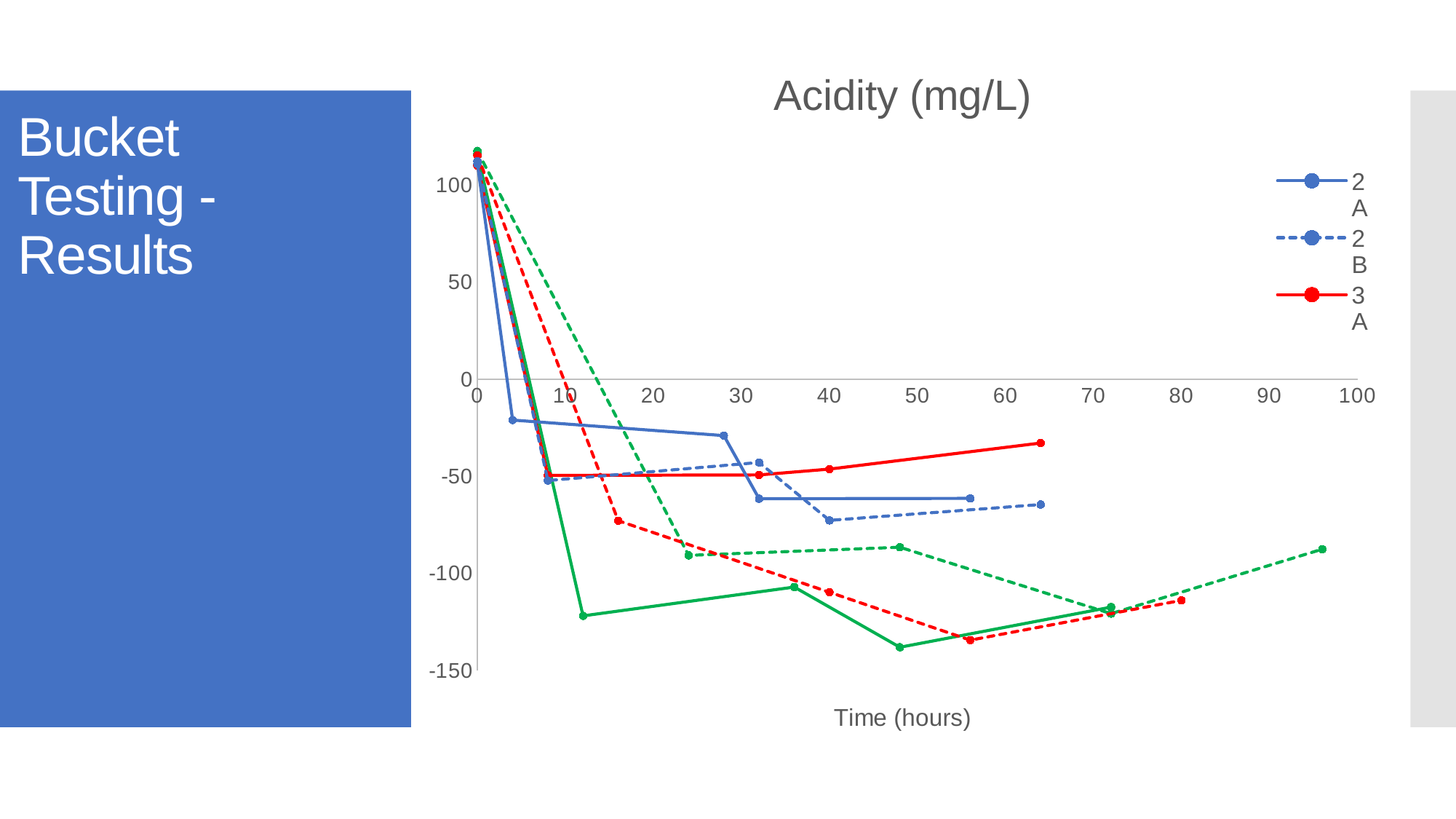
What is the label of the x axis? Time (hours) Does the value for series 3 A rise or fall between 40 and 64 hours? rise Is the value for series 2 B at 40 hours greater or less than -50? less Is the value for series 2 A at 4 hours greater or less than -50? greater Is the value for series 2 B at 64 hours greater or less than -50? less What kind of chart is shown on the slide? line chart Does the value for series 2 A rise or fall between 0 and 4 hours? fall At 64 hours, which series has the larger value, 2 B or 3 A? 3 A What is the title of the chart? Acidity (mg/L)